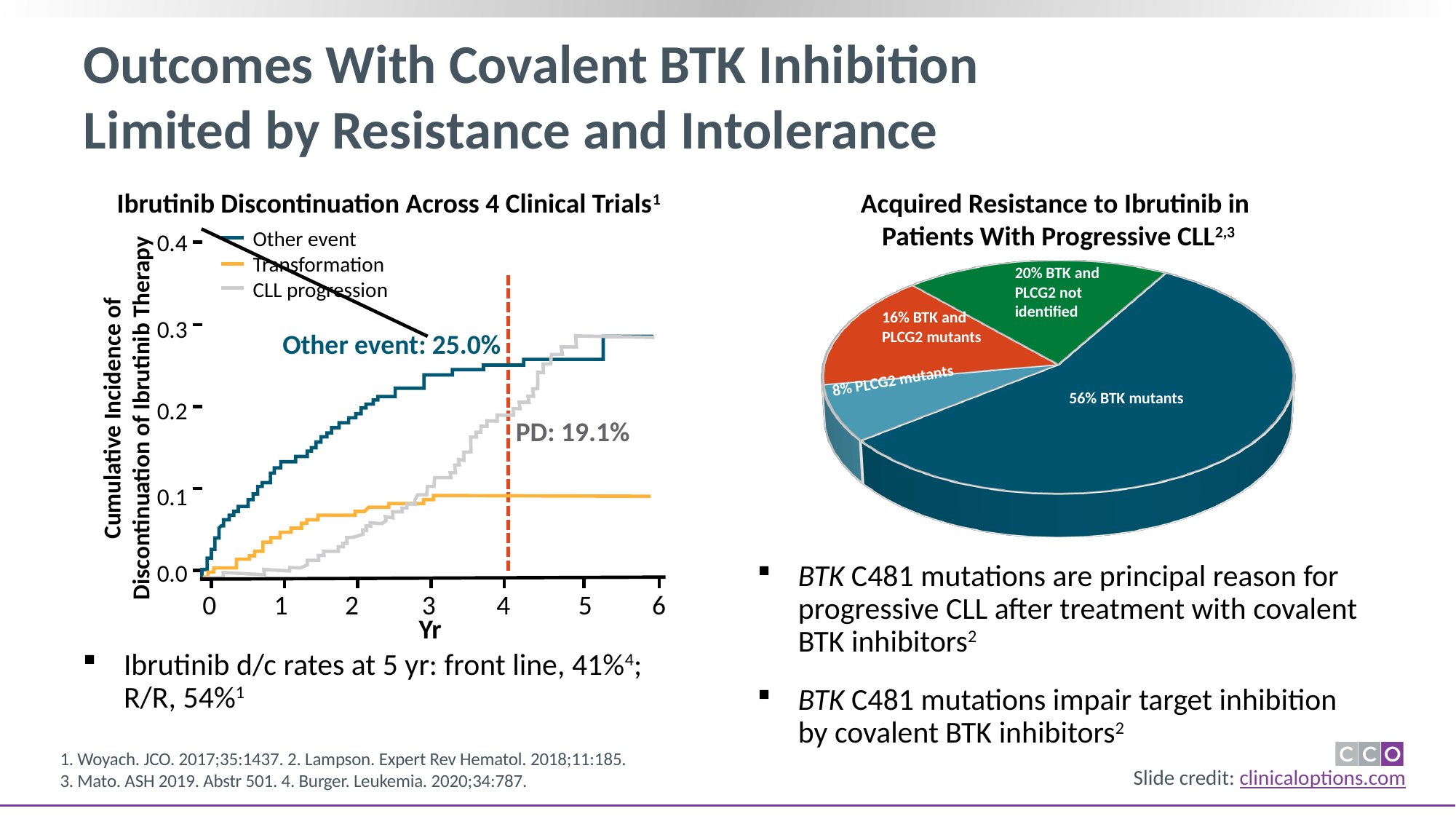
In the pie chart on the right, which category has the largest slice? BTK mutants How many series does the legend of the chart 'Ibrutinib Discontinuation Across 4 Clinical Trials' list? 3 In the chart 'Ibrutinib Discontinuation Across 4 Clinical Trials', is the value for Transformation at 5 years greater or less than 0.2? less In the pie chart on the right, which category has the smallest slice? PLCG2 mutants In the pie chart on the right, what is the difference in percentage points between the BTK mutants slice and the PLCG2 mutants slice? 48 percentage points In the chart 'Ibrutinib Discontinuation Across 4 Clinical Trials', what is the labelled cumulative incidence of PD at the dashed line at 4 years? 19.1% What kind of chart is 'Ibrutinib Discontinuation Across 4 Clinical Trials'? Line chart How many slices does the pie chart on the right have? 4 In the chart 'Ibrutinib Discontinuation Across 4 Clinical Trials', what is the labelled cumulative incidence of 'Other event' at the dashed line at 4 years? 25.0% What kind of chart is 'Acquired Resistance to Ibrutinib in Patients With Progressive CLL'? Pie chart In the pie chart on the right, which slice is larger: 'BTK and PLCG2 mutants' or 'BTK and PLCG2 not identified'? BTK and PLCG2 not identified In the pie chart 'Acquired Resistance to Ibrutinib in Patients With Progressive CLL', what share of patients have BTK mutants? 56%